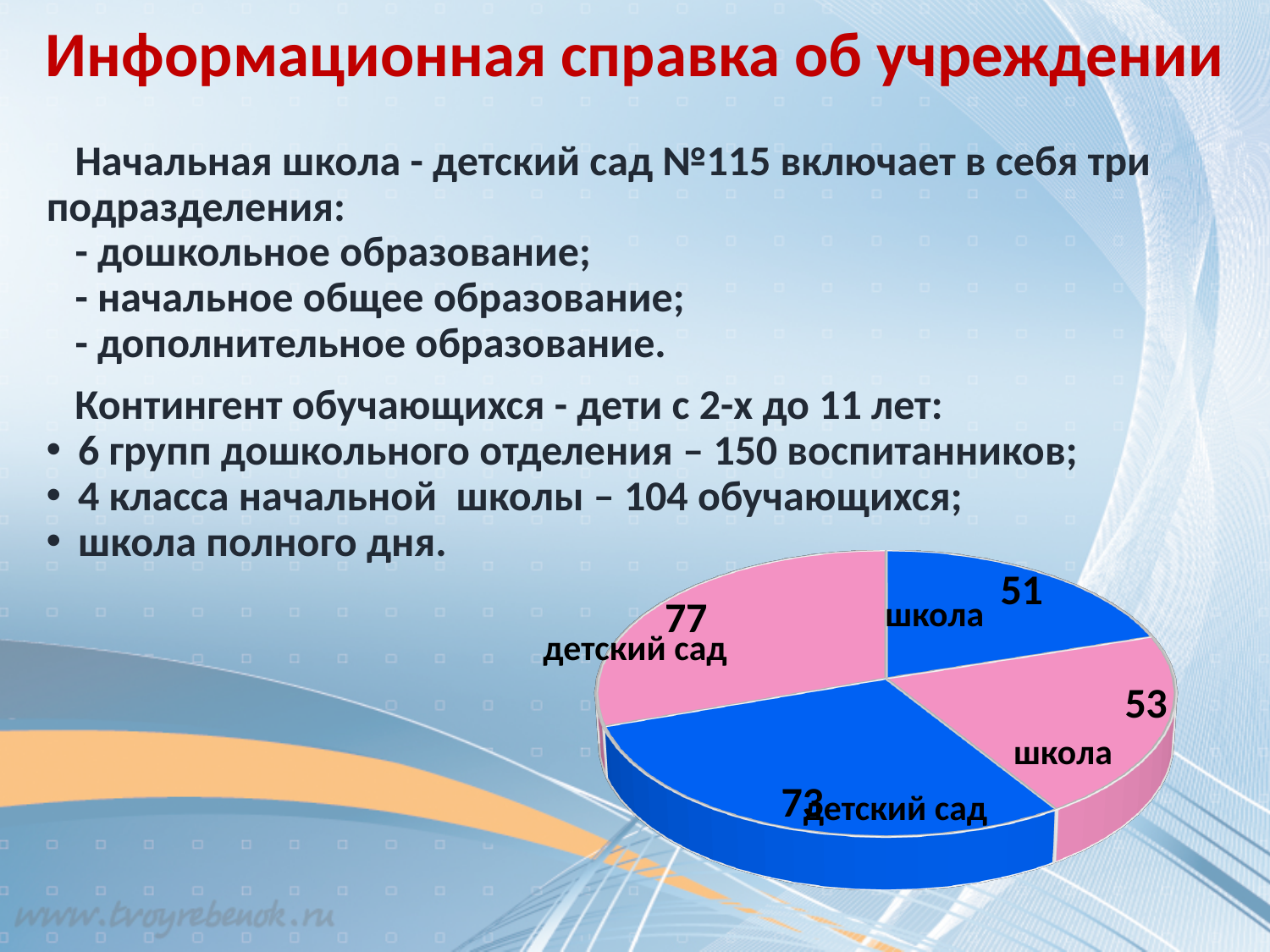
What is the value of the pink slice labelled "школа" in the pie chart? 53 What kind of chart is shown on the slide? pie chart How many slices in the pie chart are labelled "детский сад"? 2 What is the smallest value shown in the pie chart? 51 What is the largest value shown in the pie chart? 77 What is the sum of all four values shown in the pie chart? 254 How many slices does the pie chart have? 4 What is the value of the blue slice labelled "детский сад" in the pie chart? 73 Which is larger in the pie chart: the pink "школа" slice or the blue "школа" slice? the pink "школа" slice (53) What is the value of the pink slice labelled "детский сад" in the pie chart? 77 What is the difference between the largest slice (77) and the smallest slice (51) in the pie chart? 26 What is the value of the blue slice labelled "школа" in the pie chart? 51